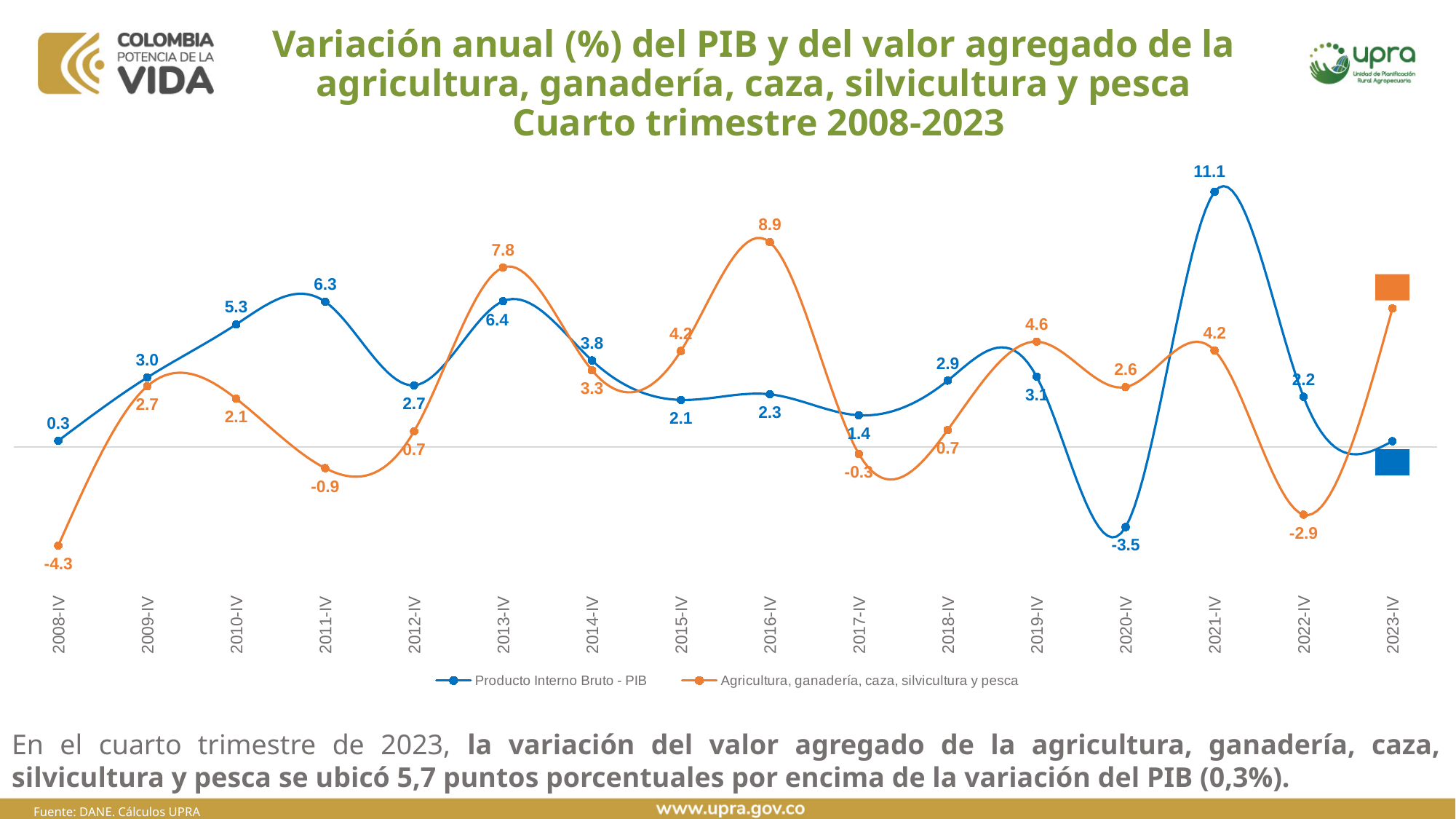
What is the value of Agricultura, ganadería, caza, silvicultura y pesca for 2016-IV? 8.9 How many periods are shown on the x axis of the chart? 16 In which period does the Agricultura, ganadería, caza, silvicultura y pesca series reach its lowest value? 2008-IV How many series does the legend list? 2 What is the value of Producto Interno Bruto - PIB for 2021-IV? 11.1 Which colour is used for the Agricultura, ganadería, caza, silvicultura y pesca series? Orange In which period does the Producto Interno Bruto - PIB series reach its highest value? 2021-IV What kind of chart is shown on the slide? Line chart What is the difference between the Agricultura, ganadería, caza, silvicultura y pesca value and the Producto Interno Bruto - PIB value in 2013-IV? 1.4 What is the value of Producto Interno Bruto - PIB for 2020-IV? -3.5 In which period does the Producto Interno Bruto - PIB series reach its lowest value? 2020-IV In 2020-IV, which series has the larger value: Producto Interno Bruto - PIB or Agricultura, ganadería, caza, silvicultura y pesca? Agricultura, ganadería, caza, silvicultura y pesca